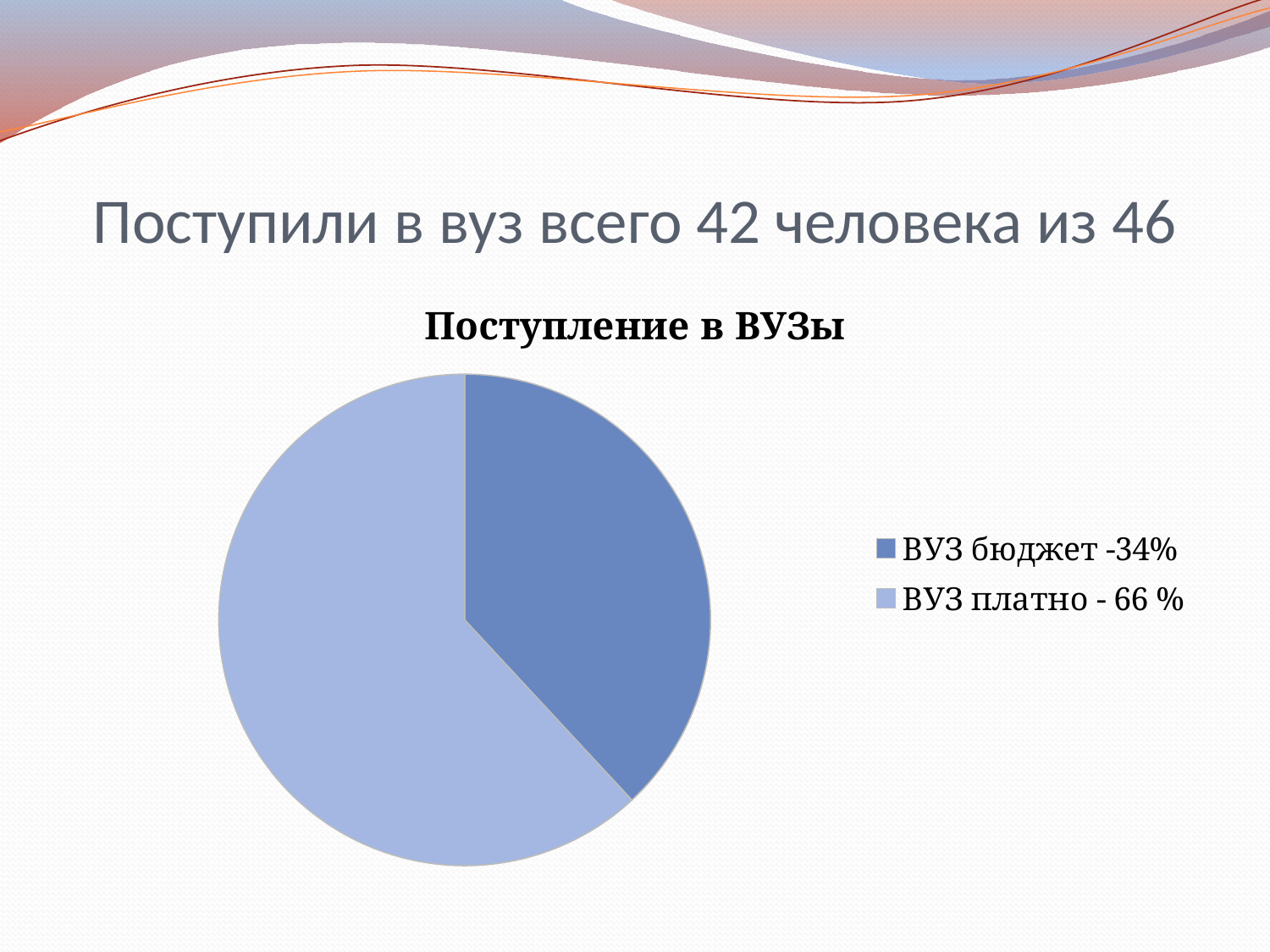
What is the difference in percentage points between the ВУЗ платно slice and the ВУЗ бюджет slice? 32 What kind of chart is shown on the slide? pie chart Which is larger, the ВУЗ бюджет slice or the ВУЗ платно slice? ВУЗ платно What is the title of the chart? Поступление в ВУЗы Which legend entry is shown in the lighter blue colour? ВУЗ платно - 66 % Which slice is the smallest? ВУЗ бюджет -34% Which slice is the largest? ВУЗ платно - 66 % How many slices does the pie chart have? 2 What share of the pie is labelled for ВУЗ платно? 66 % How many entries does the legend list? 2 What share of the pie is labelled for ВУЗ бюджет? 34%